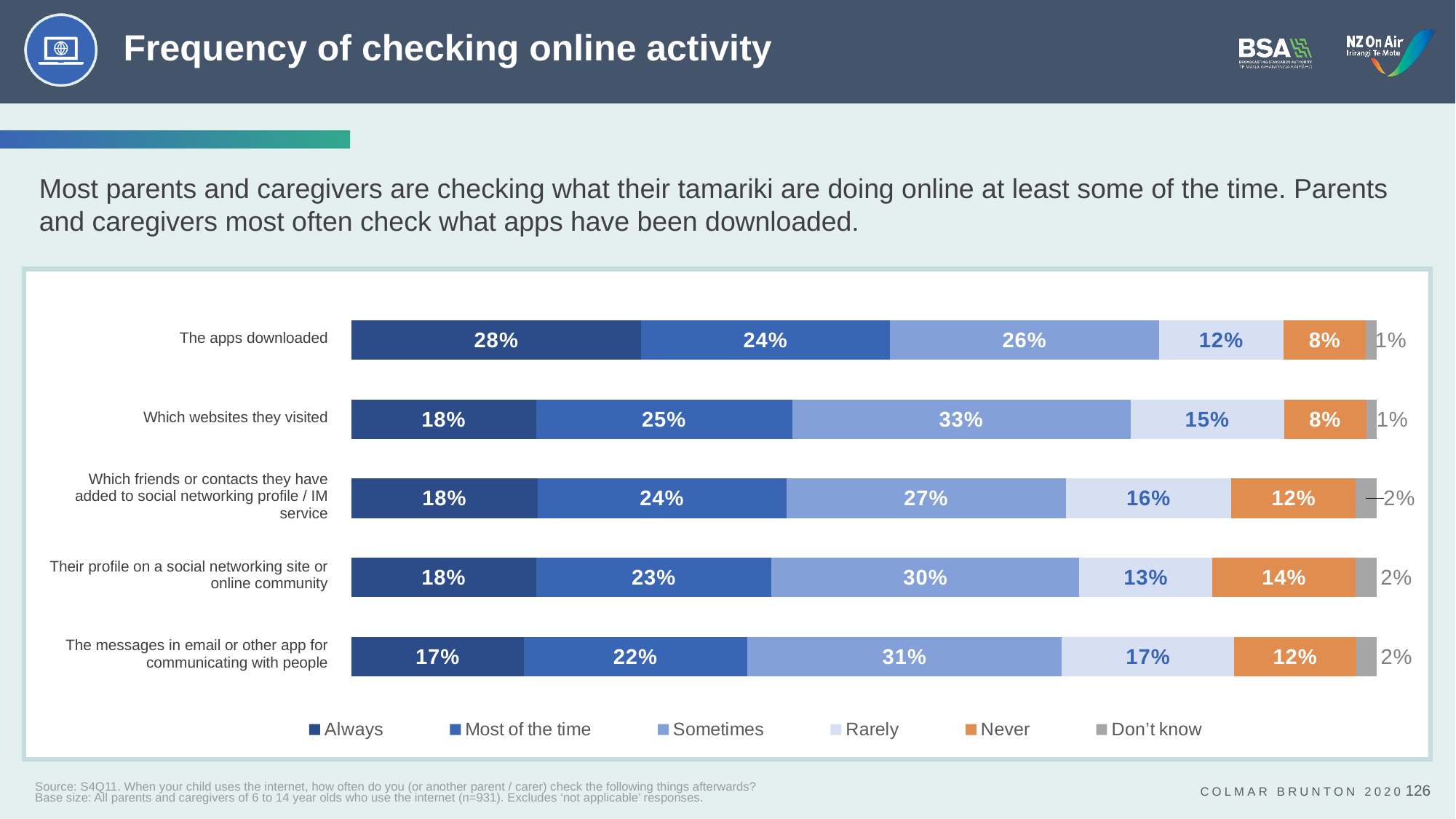
What is the difference between the 'Sometimes' value for 'Which websites they visited' and the 'Sometimes' value for 'The apps downloaded'? 7 percentage points What is the 'Sometimes' value for 'Which websites they visited'? 33% What is the combined 'Always' and 'Most of the time' value for 'The apps downloaded'? 52% Which category has the highest 'Always' value? The apps downloaded What is the 'Never' value for 'Their profile on a social networking site or online community'? 14% How many categories (activities) are shown in the chart? 5 Which category has the lowest 'Always' value? The messages in email or other app for communicating with people How many series does the legend list? 6 Which has a larger 'Never' value: 'Which friends or contacts they have added to social networking profile / IM service' or 'Their profile on a social networking site or online community'? Their profile on a social networking site or online community What kind of chart is shown on the slide? Stacked bar chart What percentage of parents and caregivers say they 'Always' check the apps downloaded? 28% Which category has the highest 'Sometimes' value? Which websites they visited